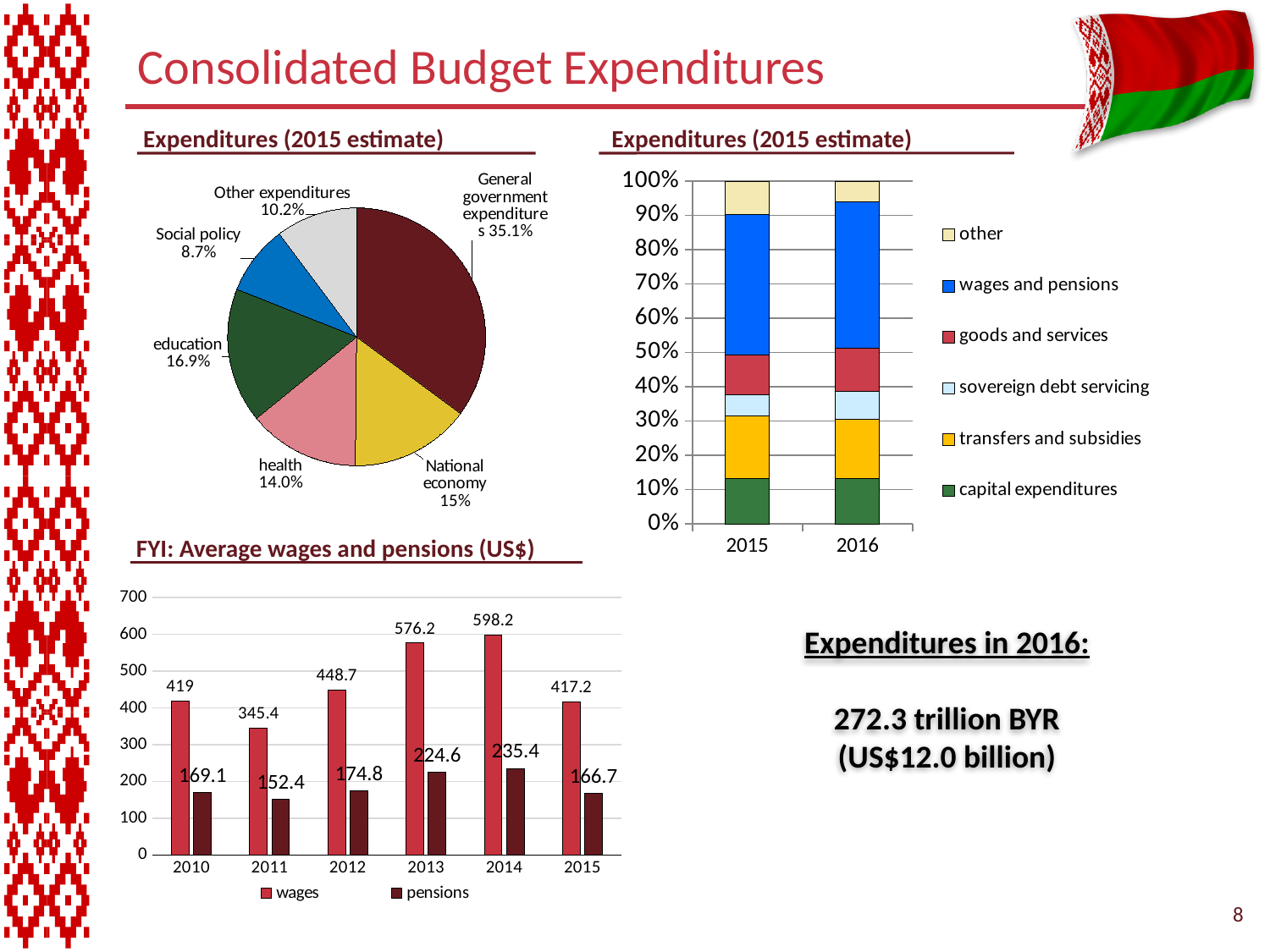
In the pie chart titled 'Expenditures (2015 estimate)', which category has the smallest share? Social policy In the pie chart titled 'Expenditures (2015 estimate)', how many slices are there? 6 In the pie chart titled 'Expenditures (2015 estimate)', what share is education? 16.9% In the stacked bar chart on the right titled 'Expenditures (2015 estimate)', how many series does the legend list? 6 In the stacked bar chart on the right titled 'Expenditures (2015 estimate)', is the top of the capital expenditures segment for 2015 greater or less than 10%? greater In the pie chart titled 'Expenditures (2015 estimate)', what share is General government expenditures? 35.1% In the chart 'FYI: Average wages and pensions (US$)', how many series does the legend list? 2 In the chart 'FYI: Average wages and pensions (US$)', which year has the highest wages value? 2014 In the chart 'FYI: Average wages and pensions (US$)', what is the value for wages in 2013? 576.2 In the chart 'FYI: Average wages and pensions (US$)', what is the difference between wages and pensions in 2014? 362.8 In the chart 'FYI: Average wages and pensions (US$)', what is the value for pensions in 2011? 152.4 In the pie chart titled 'Expenditures (2015 estimate)', what is the difference between the health share and the Other expenditures share? 3.8%